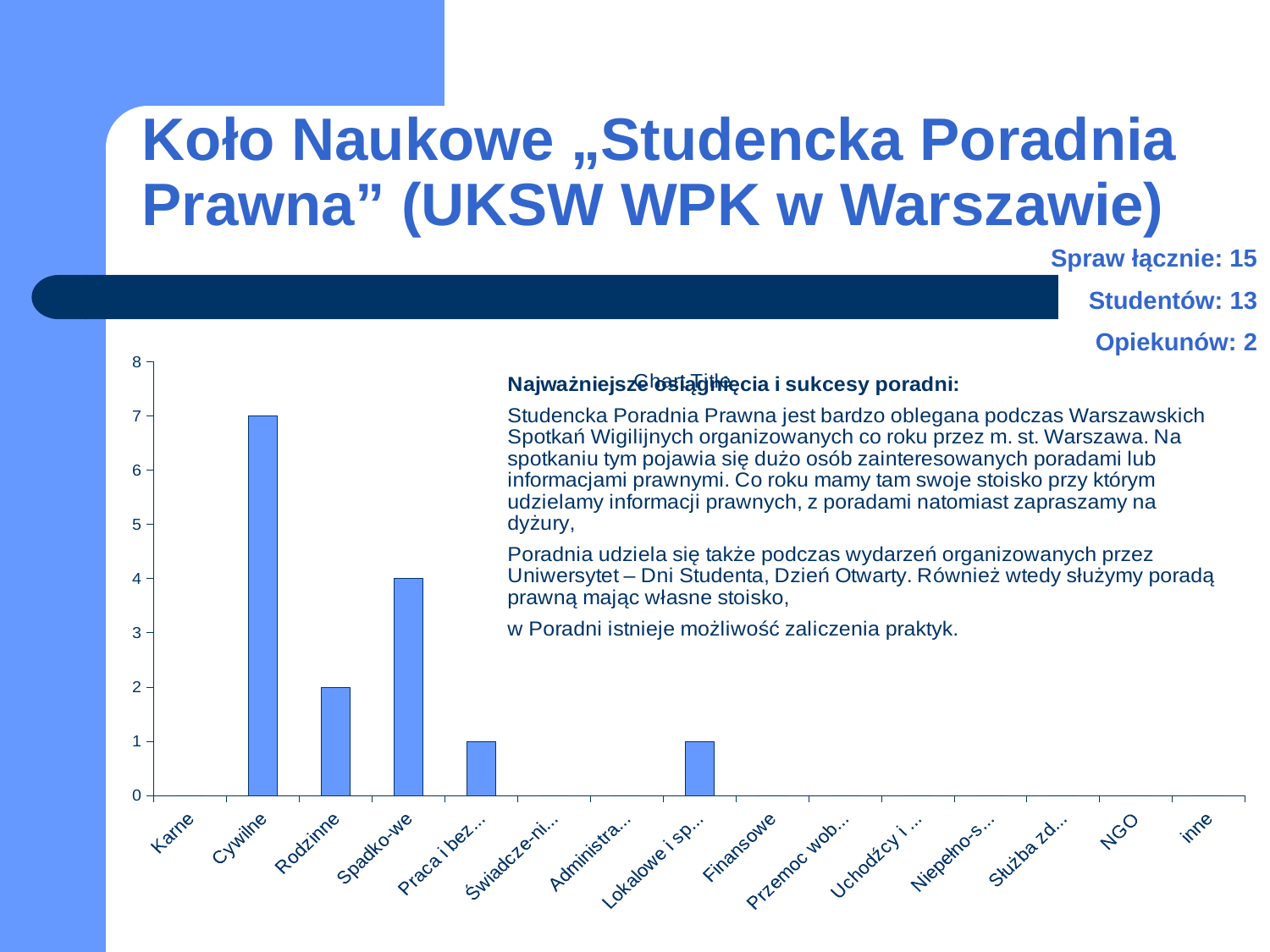
How many categories are shown on the x axis? 15 Is the value for Cywilne greater or less than 5? greater What is the highest value shown on the vertical axis? 8 What is the value for Spadko-we? 4 What is the difference between the values for Cywilne and Spadko-we? 3 What is the value for Cywilne? 7 Which category has the highest value? Cywilne What is the value for Rodzinne? 2 What is the difference between the values for Spadko-we and Rodzinne? 2 What is the value for NGO? 0 What kind of chart is shown on the slide? bar chart Which is larger, the value for Rodzinne or the value for Spadko-we? Spadko-we